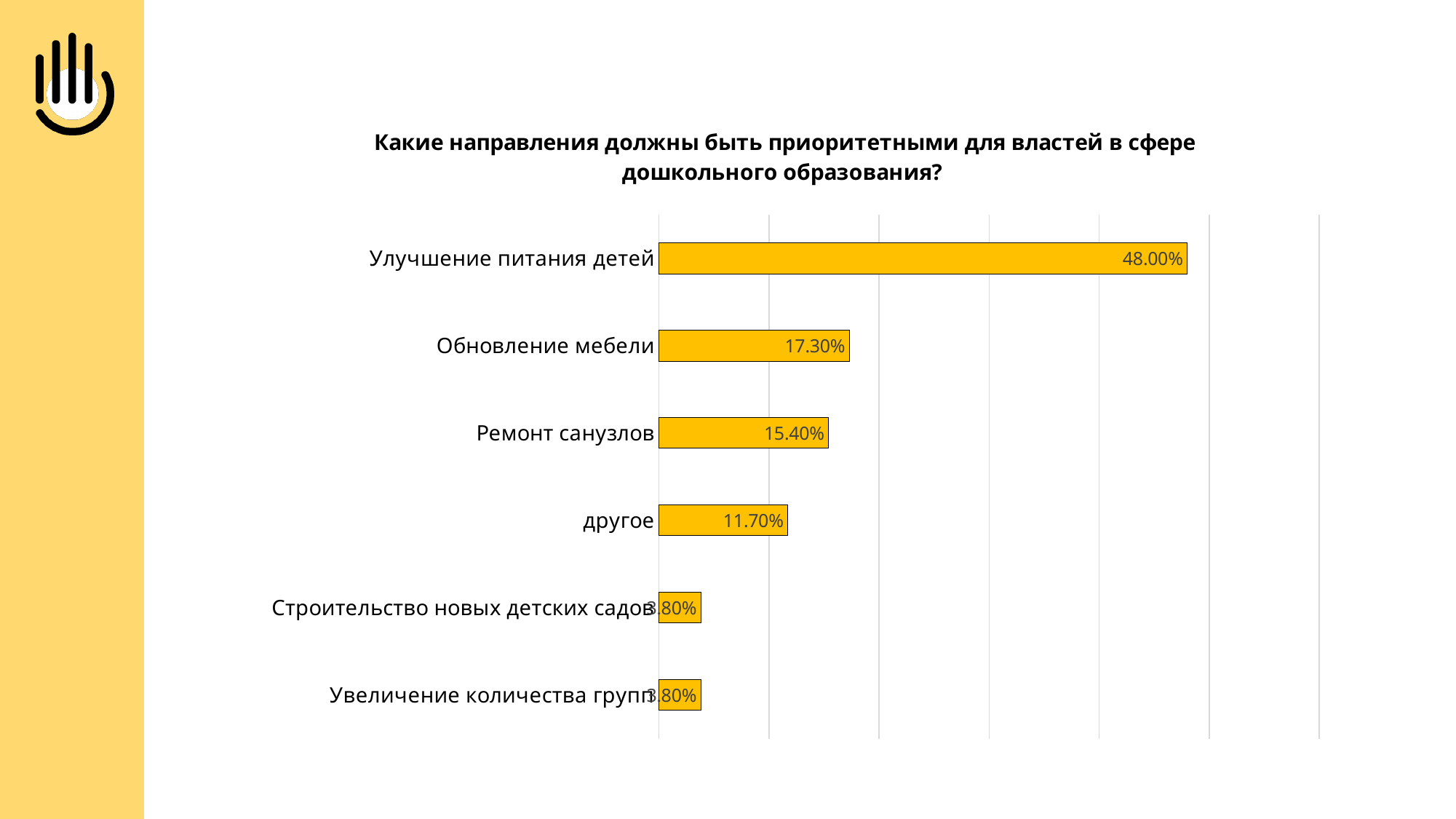
What is the value for "Улучшение питания детей"? 48.00% What is the value for "Обновление мебели"? 17.30% What is the value for "Ремонт санузлов"? 15.40% Which category has the highest value? Улучшение питания детей How many categories are shown in the chart? 6 What is the title of the chart? Какие направления должны быть приоритетными для властей в сфере дошкольного образования? Which is larger, the value for "другое" or the value for "Строительство новых детских садов"? другое What is the difference between the values for "Обновление мебели" and "Ремонт санузлов"? 1.90% Which is larger, the value for "Обновление мебели" or the value for "Ремонт санузлов"? Обновление мебели What is the value for "другое"? 11.70% What type of chart is shown on the slide? Bar chart What is the difference between the values for "Улучшение питания детей" and "Обновление мебели"? 30.70%